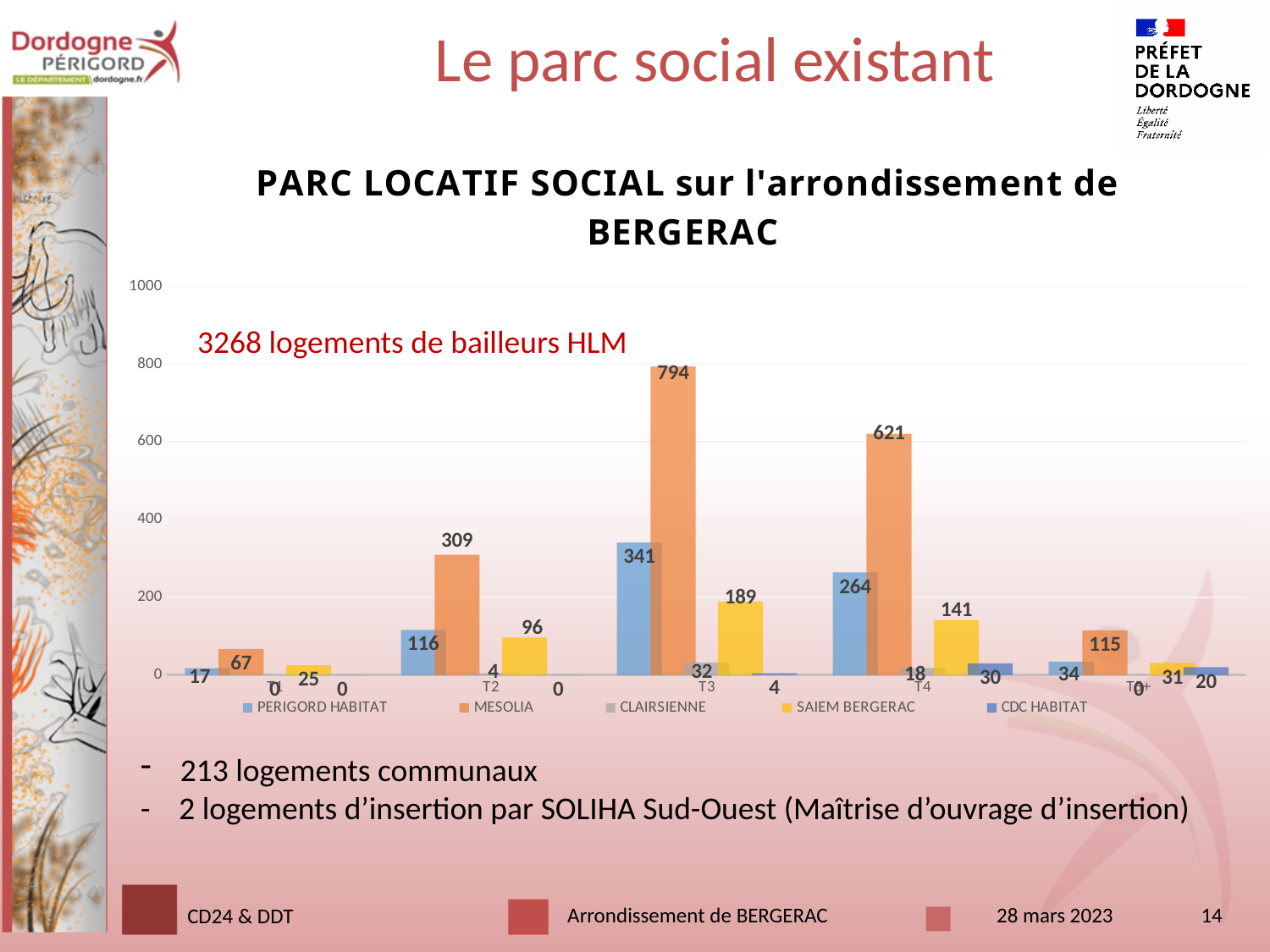
Which series has the lowest value in the T2 category? CDC HABITAT In which category does MESOLIA have its highest value? T3 Is the value for MESOLIA in the T2 category greater or less than 400? less Which is larger in the T3 category: SAIEM BERGERAC or CLAIRSIENNE? SAIEM BERGERAC What is the difference between the MESOLIA and PERIGORD HABITAT values in the T4 category? 357 How many series does the chart legend list? 5 What type of chart is shown on the slide? bar chart What is the title of the chart? PARC LOCATIF SOCIAL sur l'arrondissement de BERGERAC What is the value for CDC HABITAT in the T5+ category? 20 What is the value for PERIGORD HABITAT in the T4 category? 264 What is the value for SAIEM BERGERAC in the T2 category? 96 What is the value for MESOLIA in the T3 category? 794